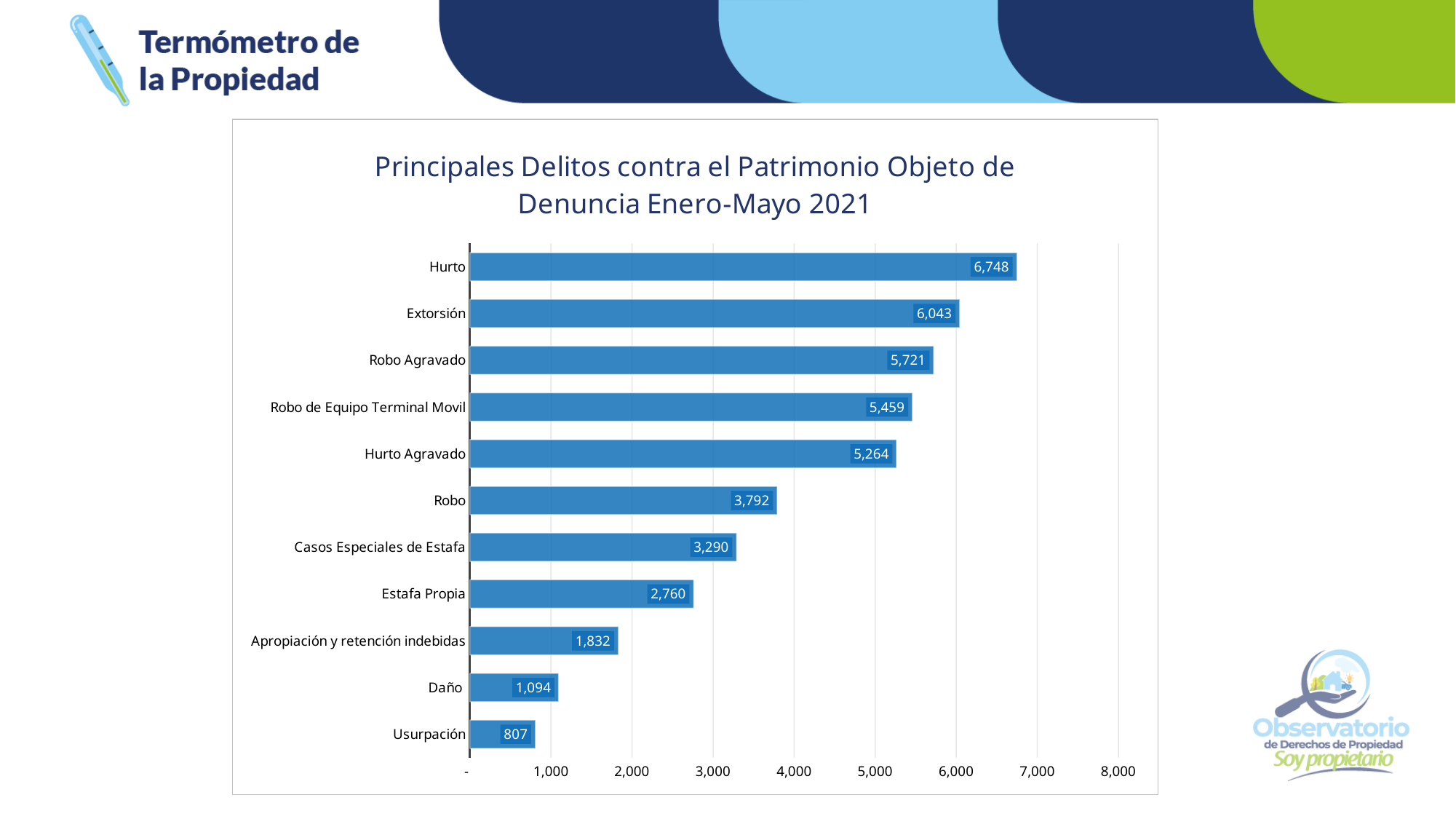
What is the difference between the values for Robo and Casos Especiales de Estafa? 502 Is the value for Estafa Propia greater or less than 3,000? less What is the value for Robo de Equipo Terminal Movil? 5,459 Which category has the lowest value? Usurpación What kind of chart is shown on the slide? bar chart What is the difference between the values for Hurto and Extorsión? 705 Which is larger, the value for Robo Agravado or the value for Hurto Agravado? Robo Agravado What is the value for Apropiación y retención indebidas? 1,832 How many categories are shown in the chart? 11 Which category has the highest value? Hurto What is the title of the chart? Principales Delitos contra el Patrimonio Objeto de Denuncia Enero-Mayo 2021 What is the value for Hurto? 6,748